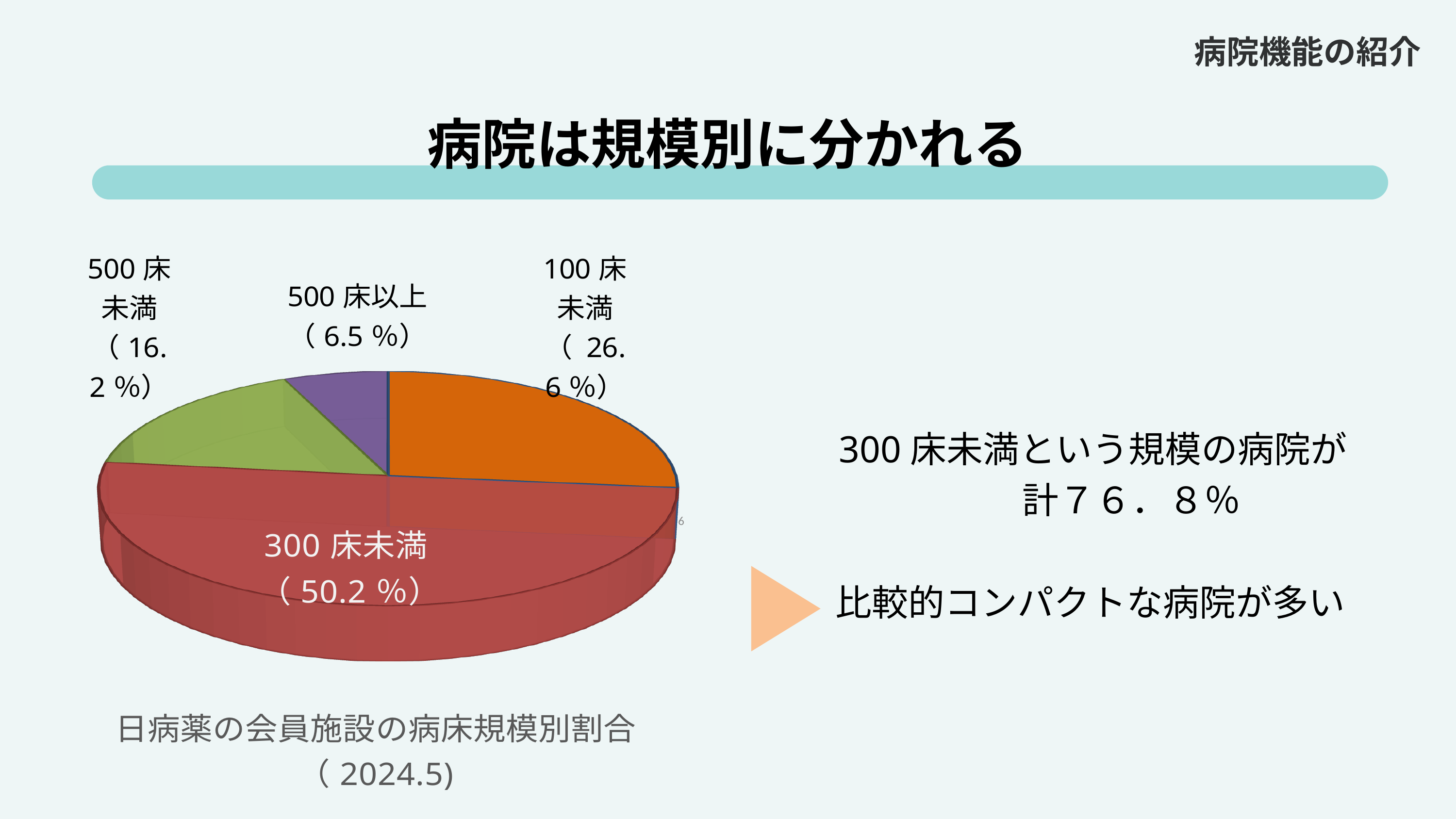
What is the title shown below the pie chart? 日病薬の会員施設の病床規模別割合（2024.5） Which category has the largest share of the pie? 300床未満 What kind of chart is shown on the slide? Pie chart Which category has the smallest share of the pie? 500床以上 Which is larger, the share for 100床未満 or the share for 500床未満? 100床未満 What is the combined share of 100床未満 and 300床未満? 76.8% What is the value shown for 100床未満? 26.6% What is the value shown for 500床未満? 16.2% What is the value shown for 500床以上? 6.5% What is the difference between the shares for 300床未満 and 100床未満? 23.6% What share of the pie does 300床未満 hold? 50.2% How many slices does the pie chart have? 4